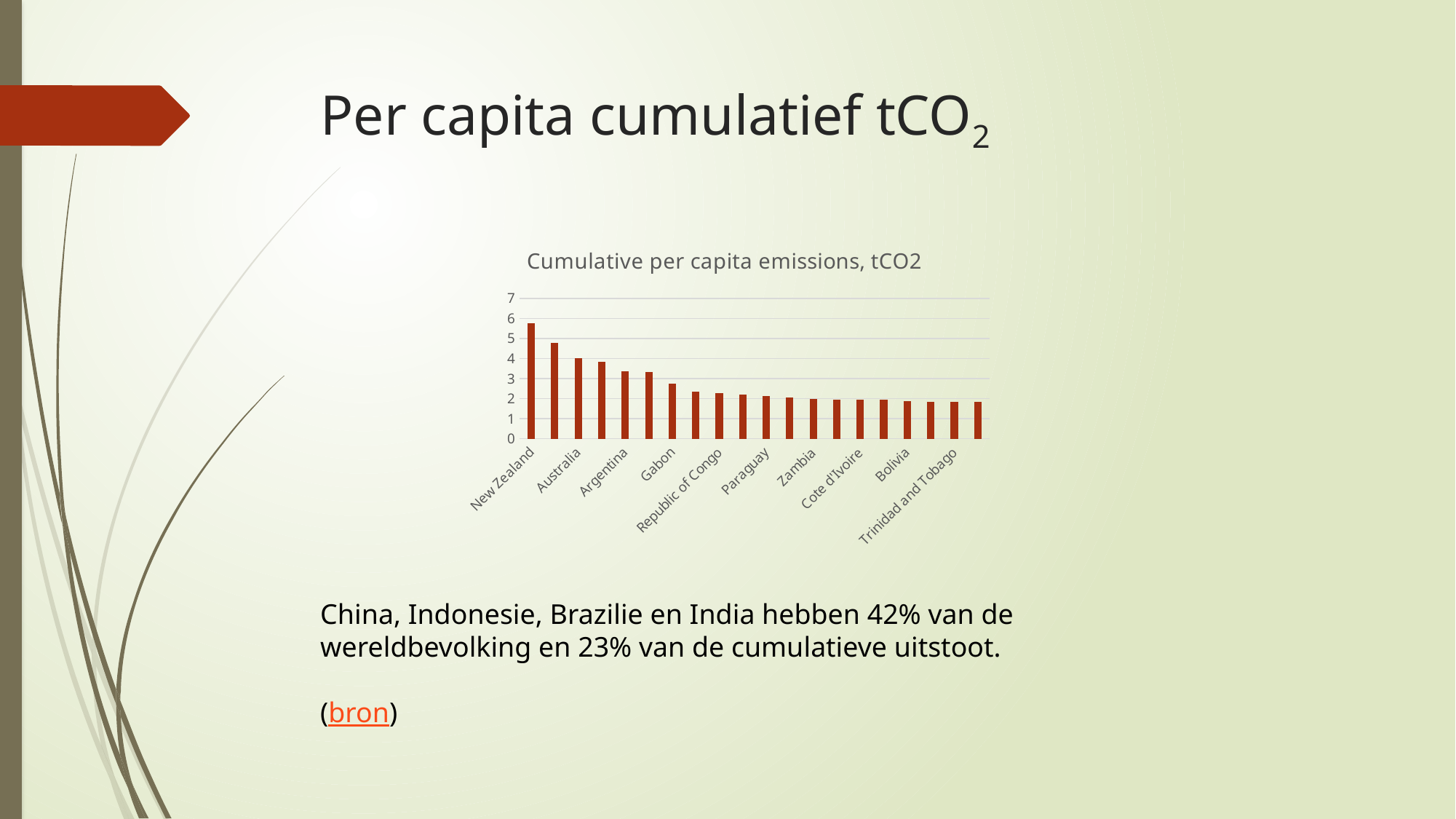
Is the value for Gabon greater or less than 3? less Which has the larger value, Gabon or Bolivia? Gabon Which country has the highest cumulative per capita emissions in the chart? New Zealand What is the title of the chart? Cumulative per capita emissions, tCO2 Which has the larger value, New Zealand or Australia? New Zealand What kind of chart is shown on the slide? bar chart Which labelled country has the lowest cumulative per capita emissions in the chart? Trinidad and Tobago Is the value for Republic of Congo greater or less than 3? less Is the value for New Zealand greater or less than 5? greater Do the values rise or fall from left to right along the x axis? fall